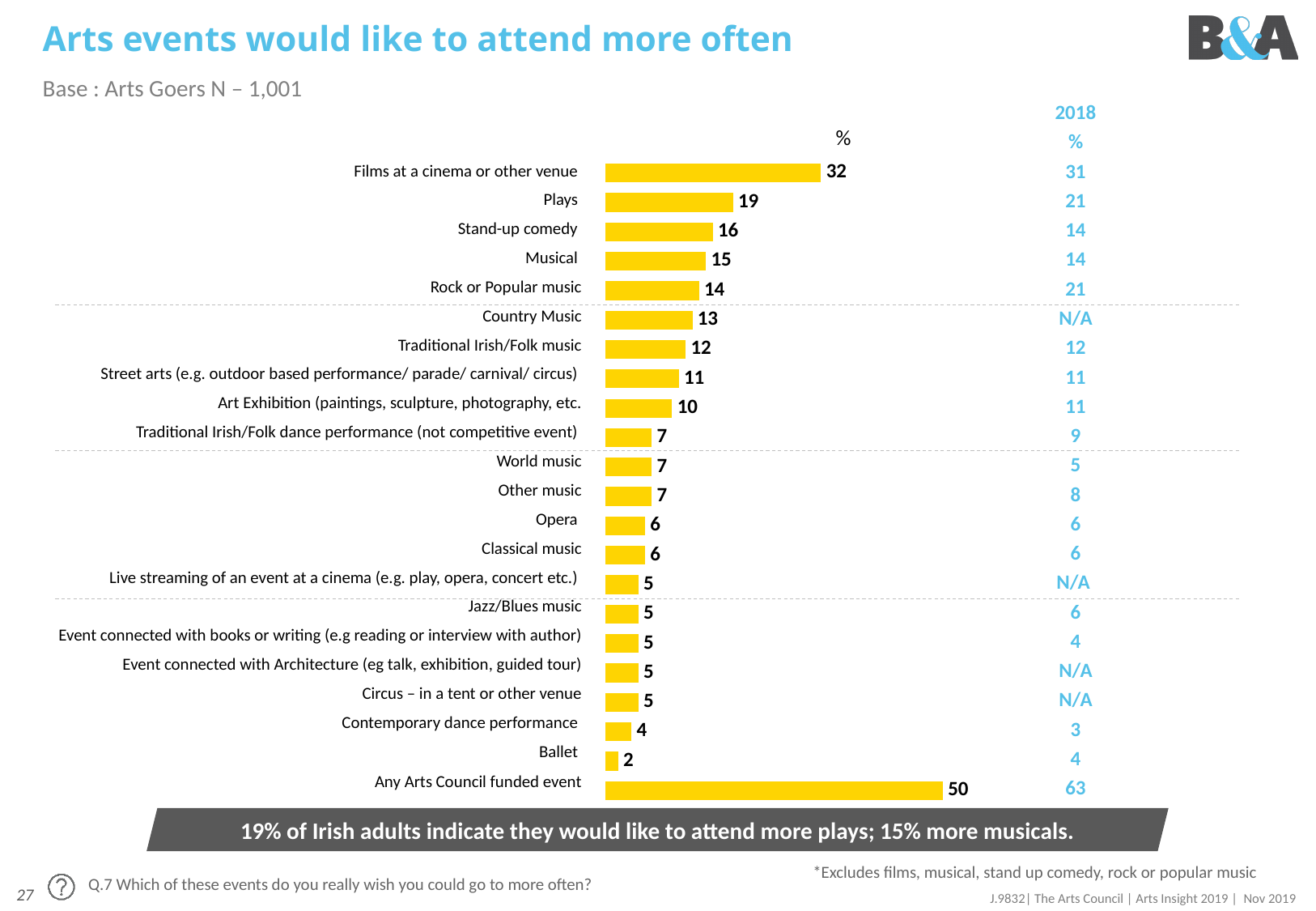
How many categories are plotted in the chart? 22 What is the title of the slide's chart? Arts events would like to attend more often What kind of chart is shown on the slide? bar chart What is the value for Ballet? 2 Which category has the lowest value in the chart? Ballet What is the value for Country Music? 13 What is the difference between the values for Films at a cinema or other venue and Plays? 13 Which has a larger value, Musical or Rock or Popular music? Musical What is the value for Stand-up comedy? 16 What is the value for Films at a cinema or other venue? 32 Which category has the highest value in the chart? Any Arts Council funded event What is the difference between the values for Any Arts Council funded event and Films at a cinema or other venue? 18